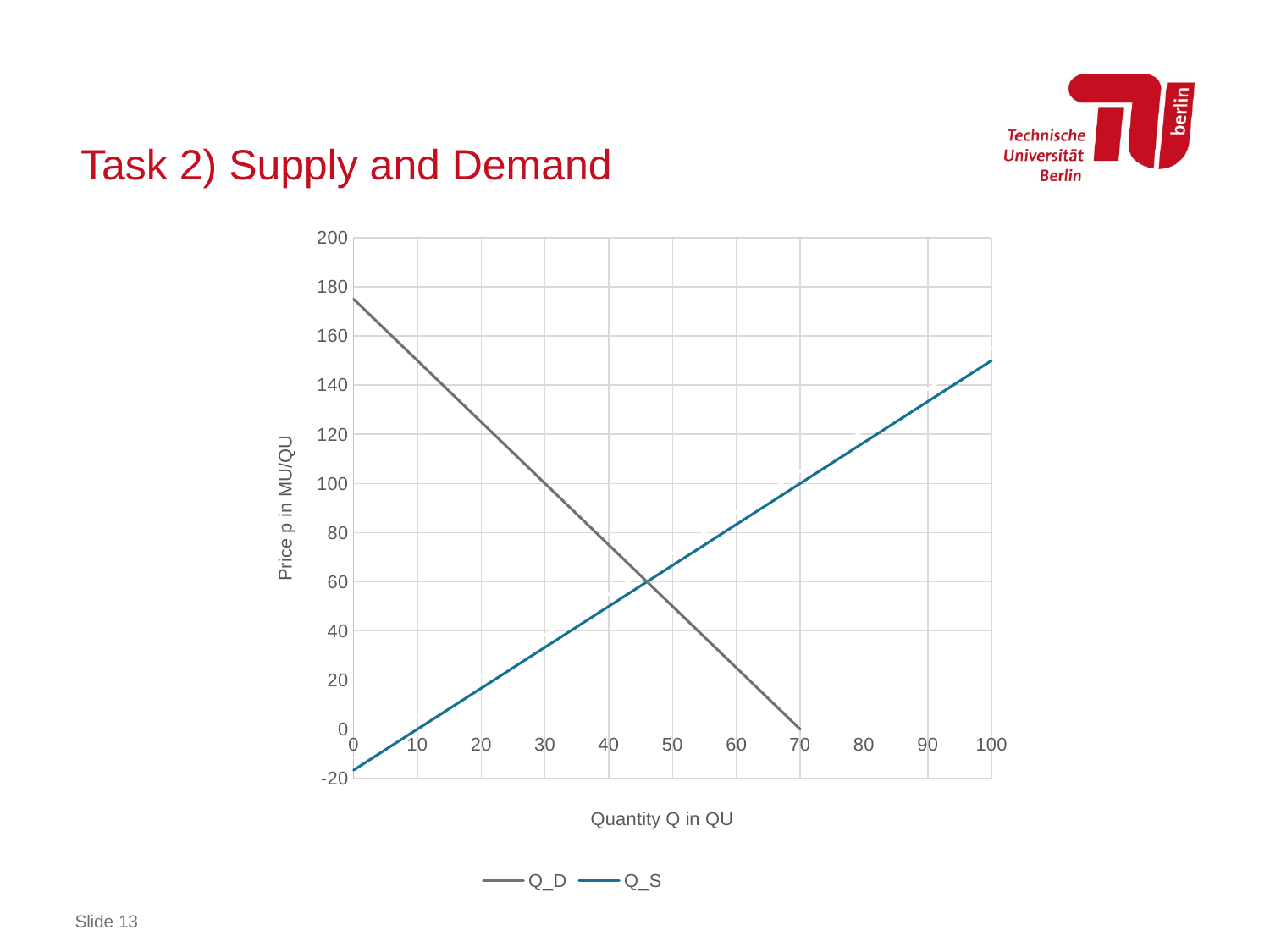
How many series does the legend list? 2 What is the title of the vertical axis? Price p in MU/QU At what quantity does the Q_D line reach a price of 0? 70 Does the Q_D line rise or fall as quantity increases along the x axis? fall Which series are listed in the legend? Q_D and Q_S At what quantity does the Q_S line cross a price of 0? 10 Is the value of Q_S at quantity 100 greater or less than 140? greater Is the value of Q_D at quantity 0 greater or less than 160? greater What kind of chart is shown on the slide? line chart Does the Q_S line rise or fall as quantity increases along the x axis? rise At quantity 60, which series has the higher price, Q_D or Q_S? Q_S At quantity 20, which series has the higher price, Q_D or Q_S? Q_D